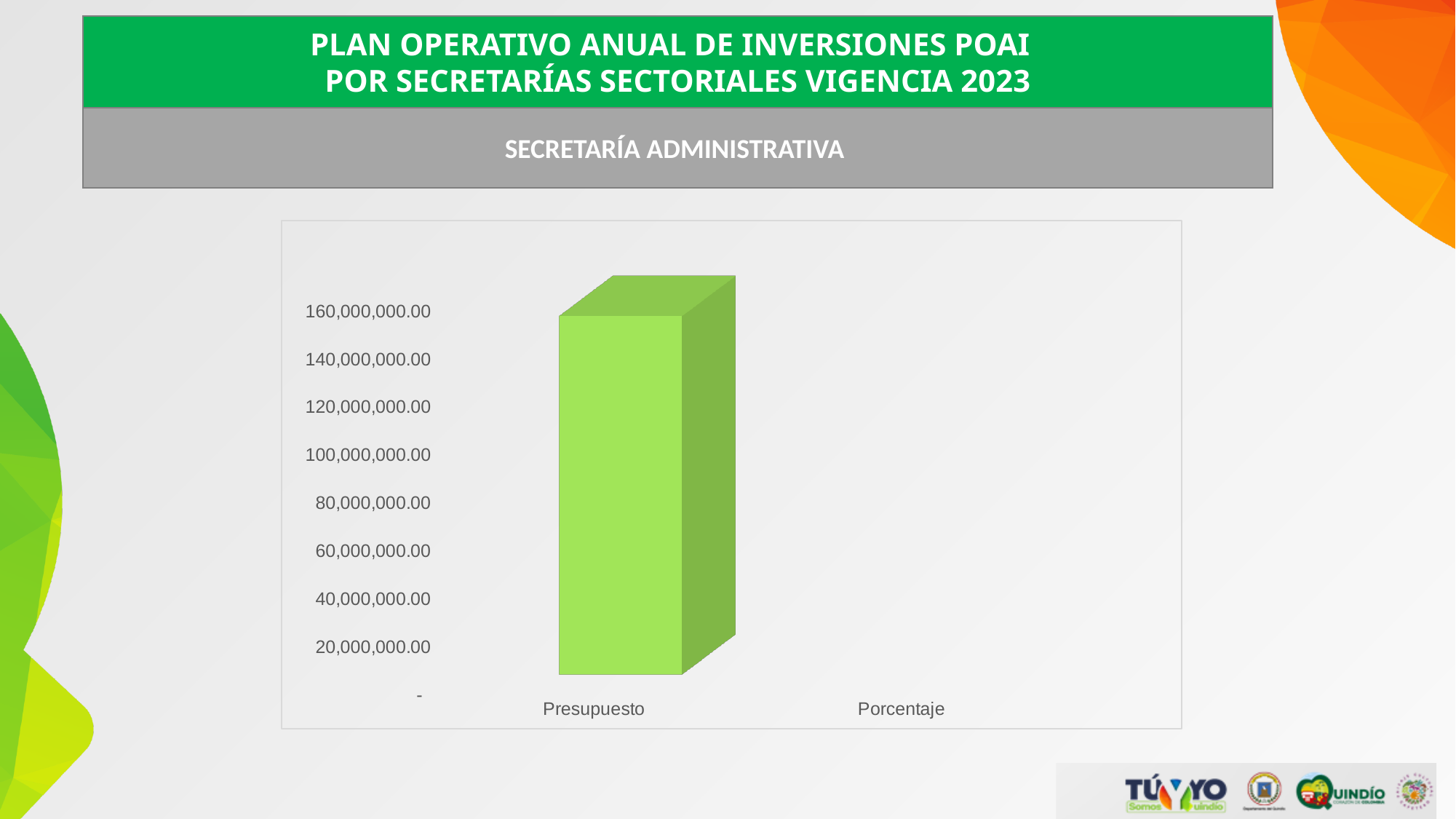
Is the value for Porcentaje greater or less than 20,000,000.00? less What is the highest tick value shown on the vertical axis of the chart? 160,000,000.00 Which secretaría is named in the grey subtitle bar above the chart? SECRETARÍA ADMINISTRATIVA Which category has the highest value in the chart? Presupuesto Which category has the lowest value in the chart? Porcentaje Is the value for Presupuesto greater or less than 100,000,000.00? greater Is the value for Presupuesto greater or less than 140,000,000.00? greater Which is larger, the value for Presupuesto or the value for Porcentaje? Presupuesto What kind of chart is shown on the slide? bar chart How many categories are shown on the x axis of the chart? 2